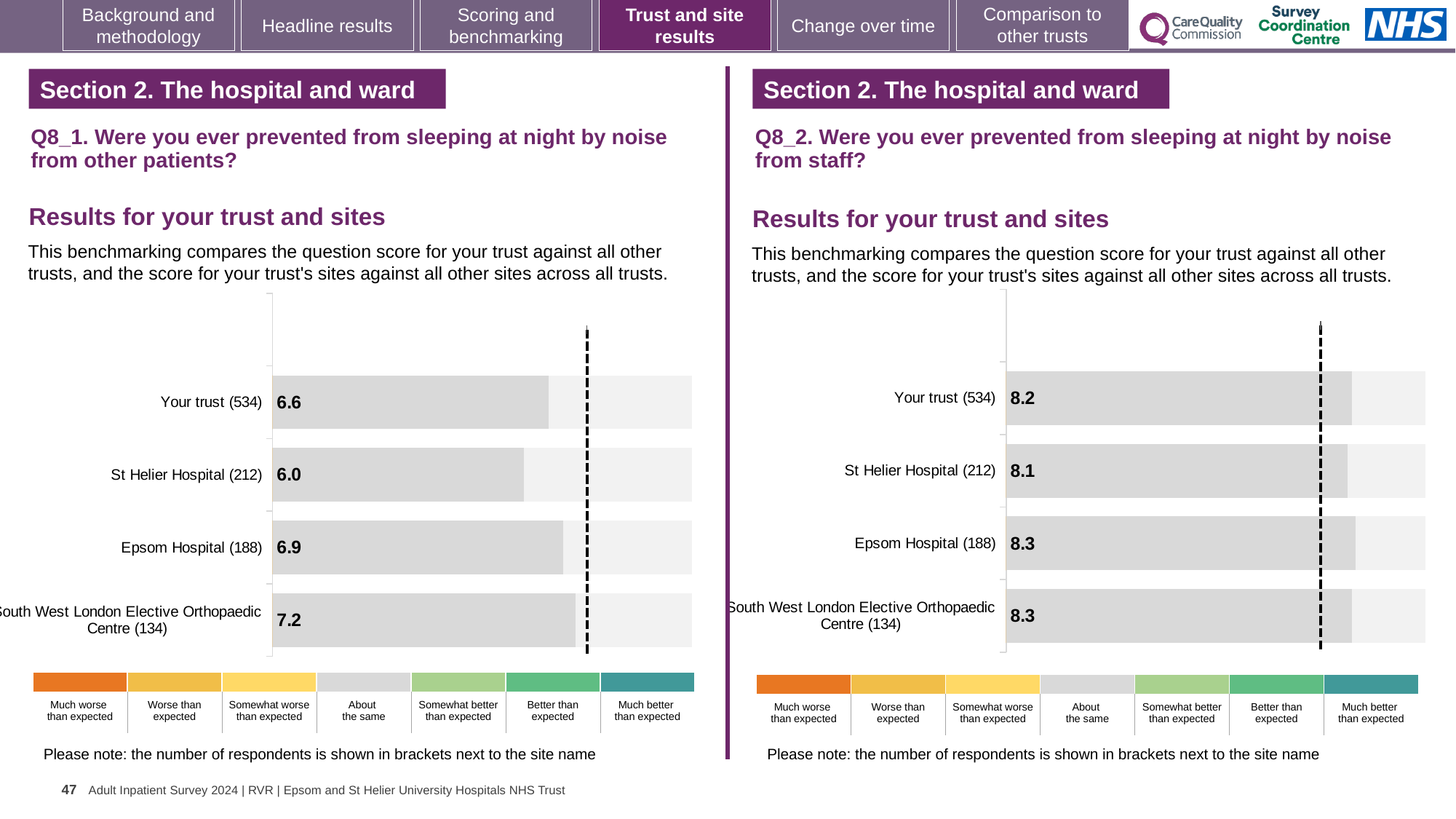
In the Q8_1 chart (noise from other patients), what is the difference between the scores for South West London Elective Orthopaedic Centre (134) and St Helier Hospital (212)? 1.2 In the Q8_2 chart (noise from staff), what is the difference between the scores for Epsom Hospital (188) and Your trust (534)? 0.1 In the Q8_2 chart (noise from staff), what is the score for Epsom Hospital (188)? 8.3 In the Q8_1 chart (noise from other patients), which has the higher score: Epsom Hospital (188) or Your trust (534)? Epsom Hospital (188) In the Q8_2 chart (noise from staff), which site has the lowest score? St Helier Hospital (212) In the Q8_1 chart (noise from other patients), which site has the lowest score? St Helier Hospital (212) In the Q8_1 chart (noise from other patients), which site has the highest score? South West London Elective Orthopaedic Centre (134) How many bars are shown in the Q8_2 chart (noise from staff)? 4 What type of chart is used for the Q8_1 results (noise from other patients)? Bar chart In the Q8_1 chart (noise from other patients), what is the score for Your trust (534)? 6.6 In the Q8_2 chart (noise from staff), what is the score for Your trust (534)? 8.2 In the Q8_1 chart (noise from other patients), what is the score for St Helier Hospital (212)? 6.0